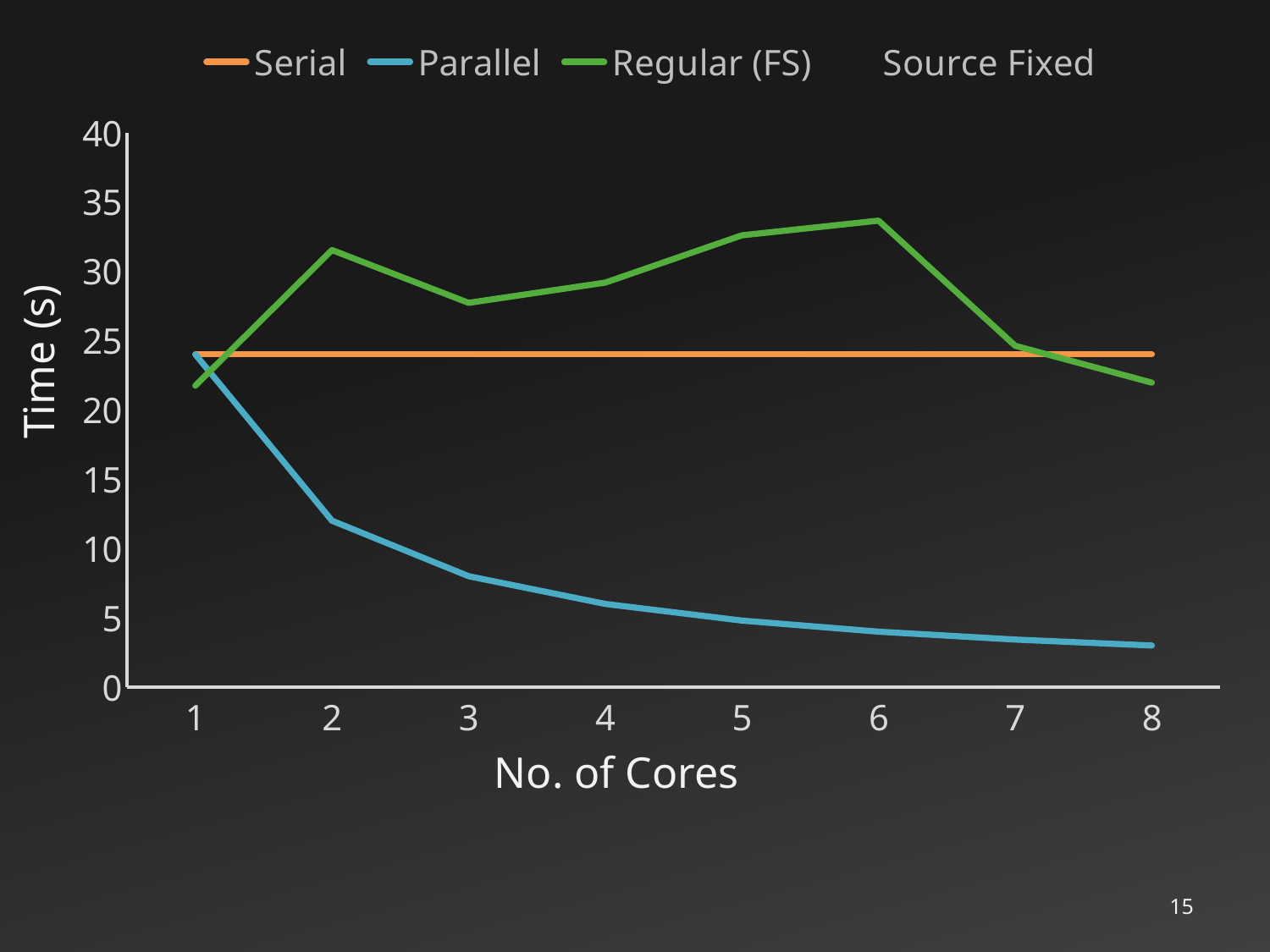
How many series does the legend list? 4 What kind of chart is shown on the slide? line chart At 4 cores, which series has the larger value, Regular (FS) or Parallel? Regular (FS) How many values of No. of Cores are plotted along the x axis? 8 At which number of cores is the Parallel series lowest? 8 At which number of cores is the Regular (FS) series highest? 6 Is the Regular (FS) value at 6 cores greater or less than 30? greater Does the Parallel series rise or fall as the number of cores increases? fall Is the Parallel value at 2 cores greater or less than 15? less Is the Parallel value at 8 cores greater or less than 5? less What is the label of the y axis? Time (s)